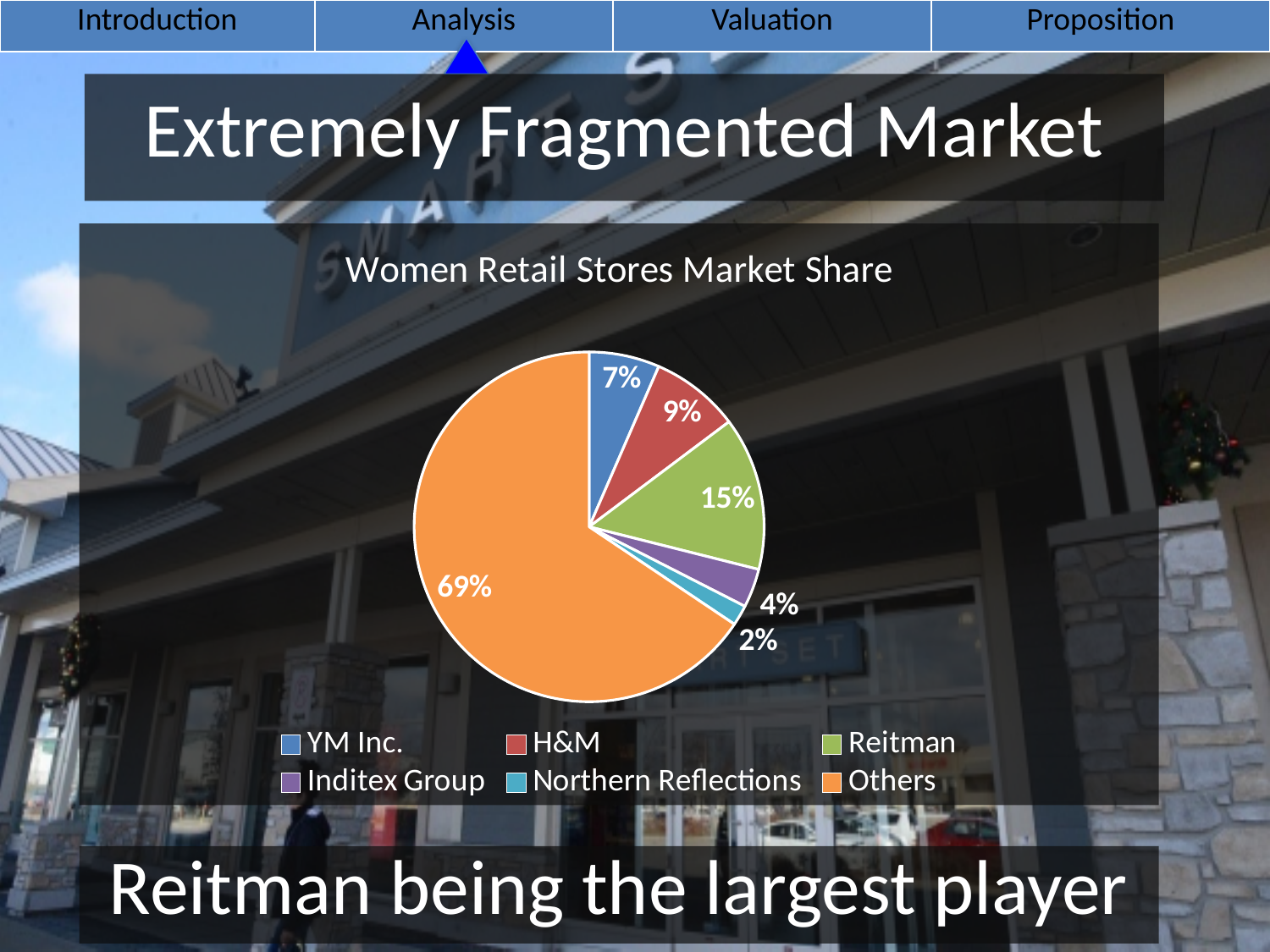
How many categories does the legend list? 6 What share of the market does YM Inc. hold? 7% What share of the market does Northern Reflections hold? 2% What share of the market does H&M hold? 9% What is the difference in market share between Reitman and H&M? 6% Which named company (excluding Others) has the largest slice of the pie? Reitman What share of the market is labelled Others? 69% What type of chart is shown on the slide? pie chart What is the title of the chart? Women Retail Stores Market Share Which category has the smallest slice of the pie? Northern Reflections Which has a larger market share, Inditex Group or YM Inc.? YM Inc. What share of the market does Reitman hold? 15%